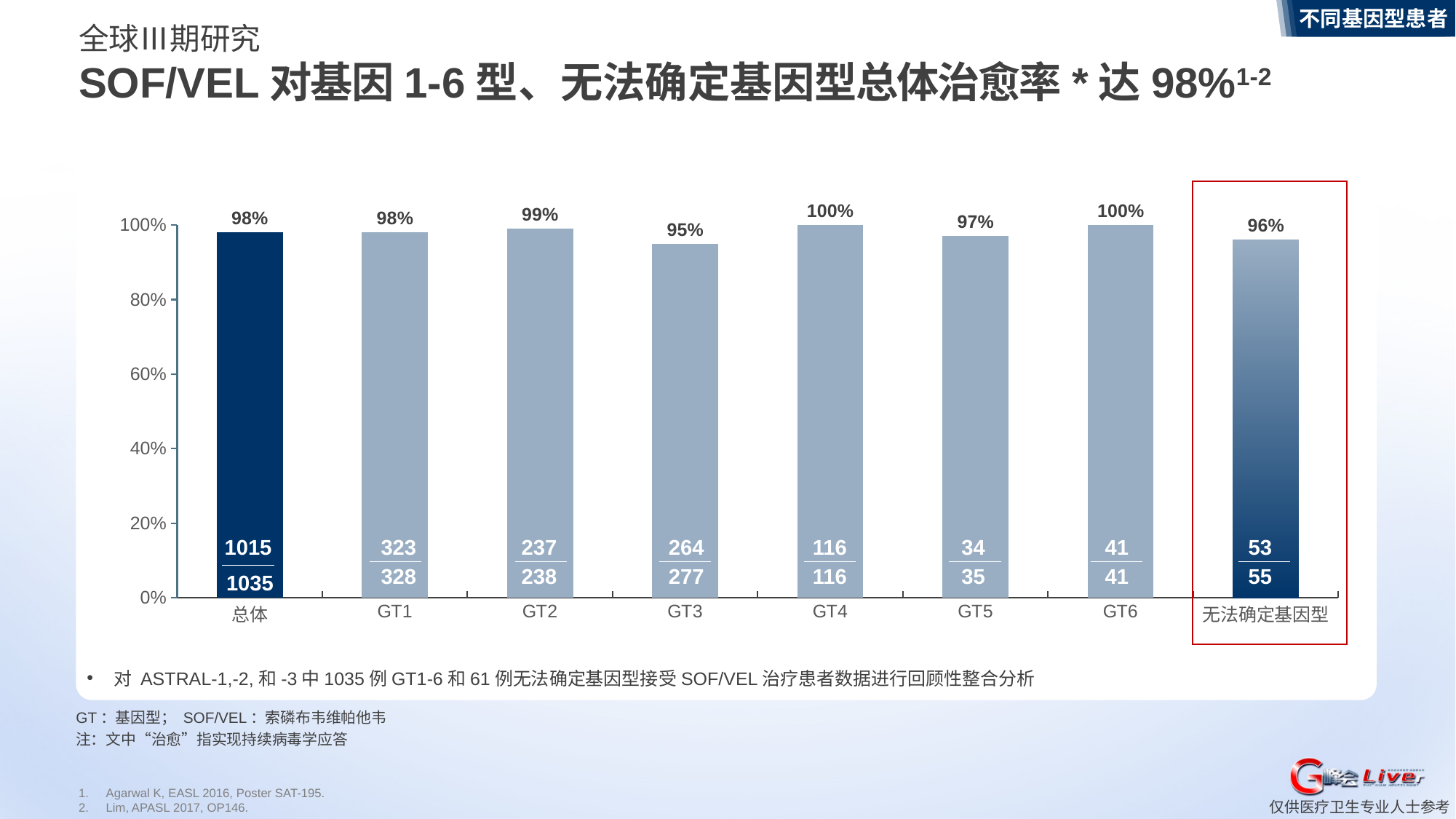
What is the cure rate shown for GT3? 95% What kind of chart is shown on the slide? Bar chart What fraction of patients is printed on the GT5 bar? 34/35 What is the difference between the cure rates for GT2 and GT3? 4% How many categories are shown on the x axis? 8 What fraction of patients is printed on the 总体 bar? 1015/1035 What is the cure rate shown for 无法确定基因型? 96% Which category has the lowest cure rate? GT3 Which has a higher cure rate, GT5 or GT3? GT5 What is the cure rate shown for 总体? 98% Which two categories share the highest cure rate of 100%? GT4 and GT6 Is the value for GT1 greater or less than 80%? greater